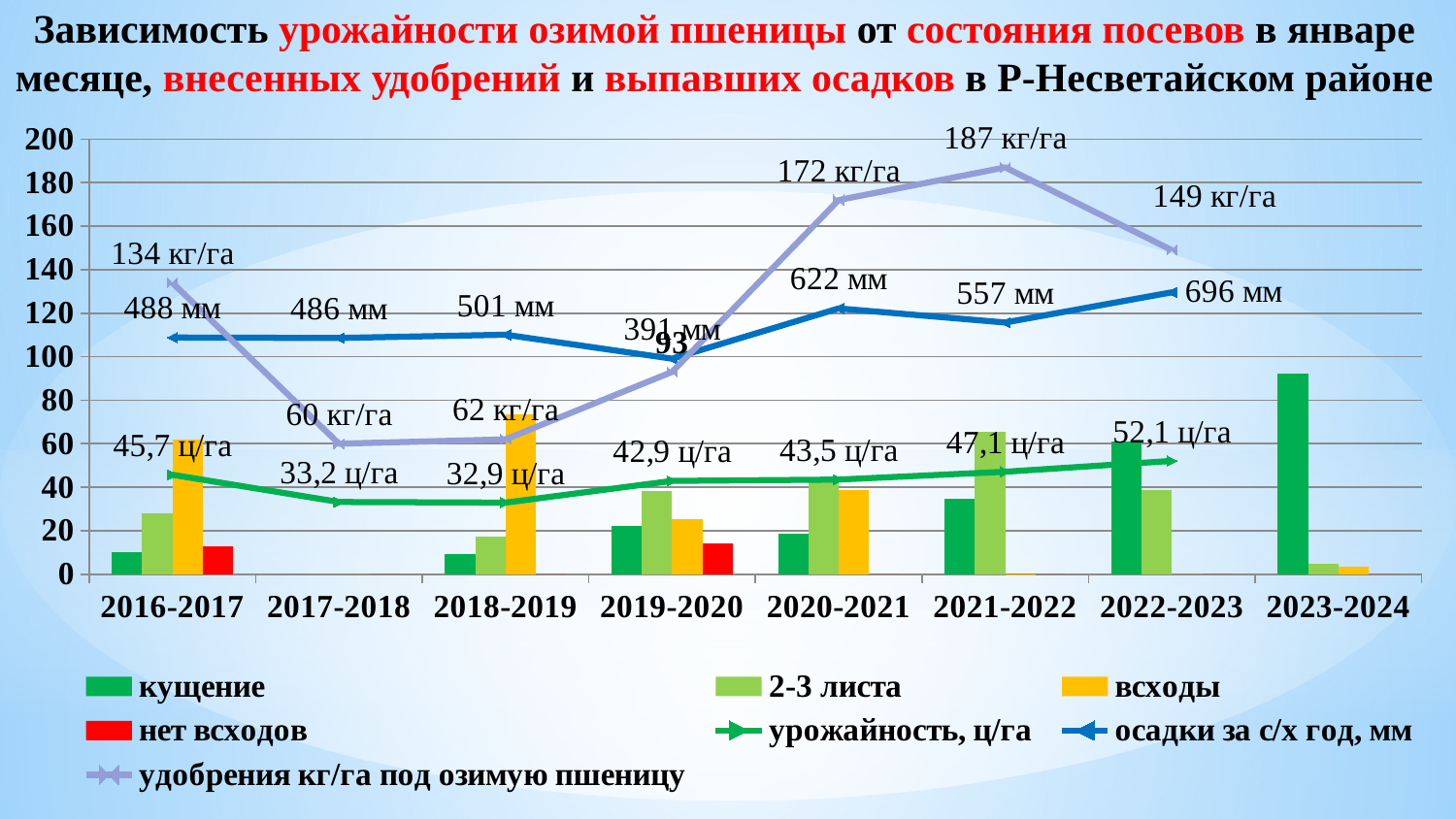
By how much does the yield in 2022-2023 exceed the yield in 2016-2017? 6,4 ц/га Which is larger: the fertilizer value for 2016-2017 or for 2022-2023? 2022-2023 Which season has the lowest labelled yield (урожайность)? 2018-2019 Which season has the highest labelled fertilizer (удобрения) value? 2021-2022 What is the difference between the precipitation in 2022-2023 and in 2021-2022? 139 мм How many seasons (categories) are shown on the x axis? 8 Which season has the lowest labelled precipitation (осадки) value? 2019-2020 What is the fertilizer (удобрения) value labelled for 2021-2022? 187 кг/га What is the precipitation (осадки) value labelled for 2019-2020? 391 мм What is the yield (урожайность) value labelled for 2022-2023? 52,1 ц/га How many series does the legend list? 7 Which season has the highest labelled yield (урожайность)? 2022-2023